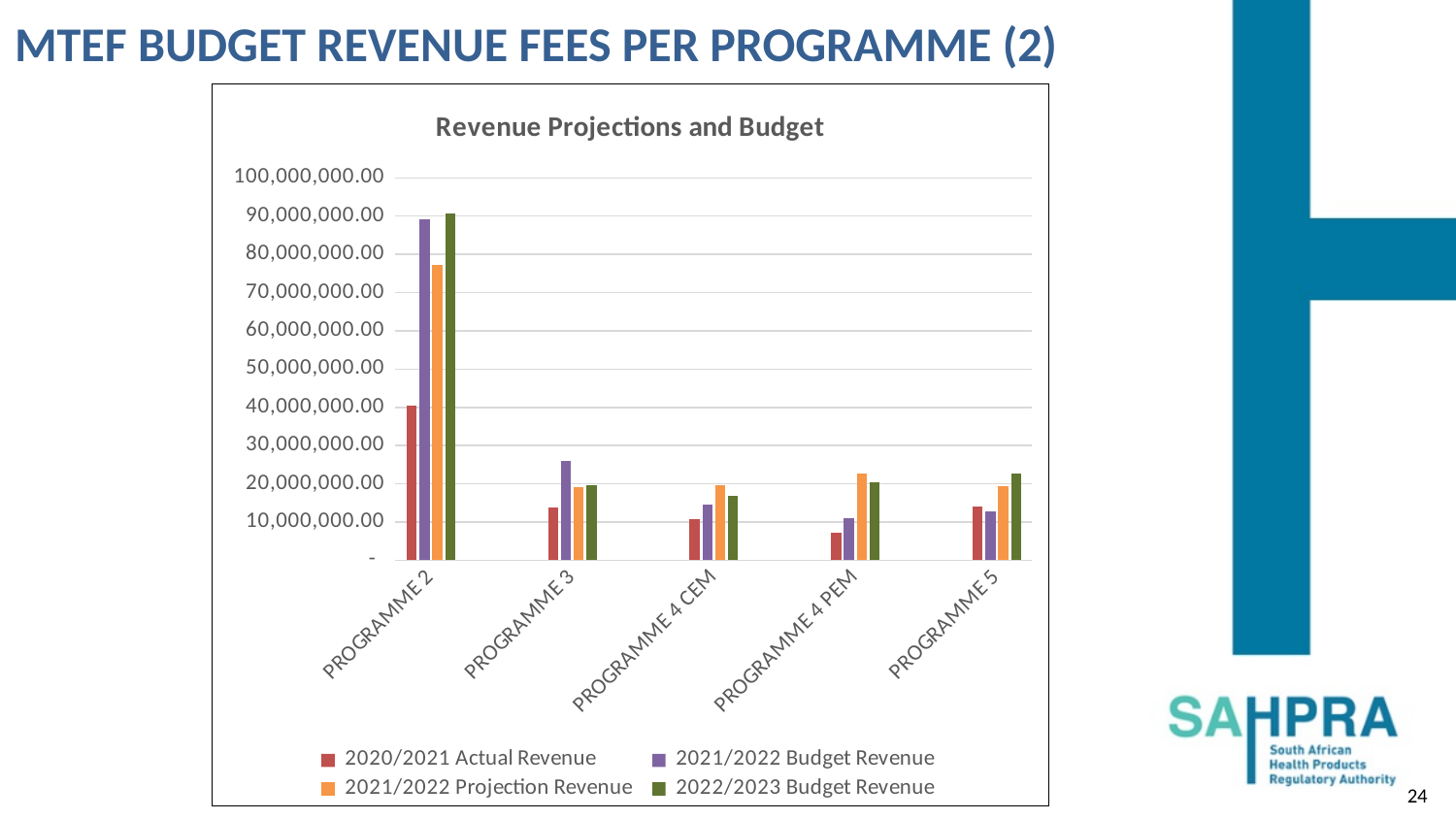
Which programme has the highest 2021/2022 Budget Revenue? PROGRAMME 2 What is the title of the chart? Revenue Projections and Budget For PROGRAMME 4 PEM, which is larger: the 2021/2022 Projection Revenue or the 2020/2021 Actual Revenue? 2021/2022 Projection Revenue How many series does the chart's legend list? 4 Which has the larger 2021/2022 Budget Revenue: PROGRAMME 2 or PROGRAMME 3? PROGRAMME 2 How many programmes are shown on the x axis of the chart? 5 Which programme has the lowest 2020/2021 Actual Revenue? PROGRAMME 4 PEM Is the 2020/2021 Actual Revenue for PROGRAMME 4 CEM greater or less than 20,000,000.00? less Is the 2020/2021 Actual Revenue for PROGRAMME 2 greater or less than 30,000,000.00? greater What kind of chart is shown on the slide? Bar chart Is the 2021/2022 Budget Revenue for PROGRAMME 3 greater or less than 20,000,000.00? greater